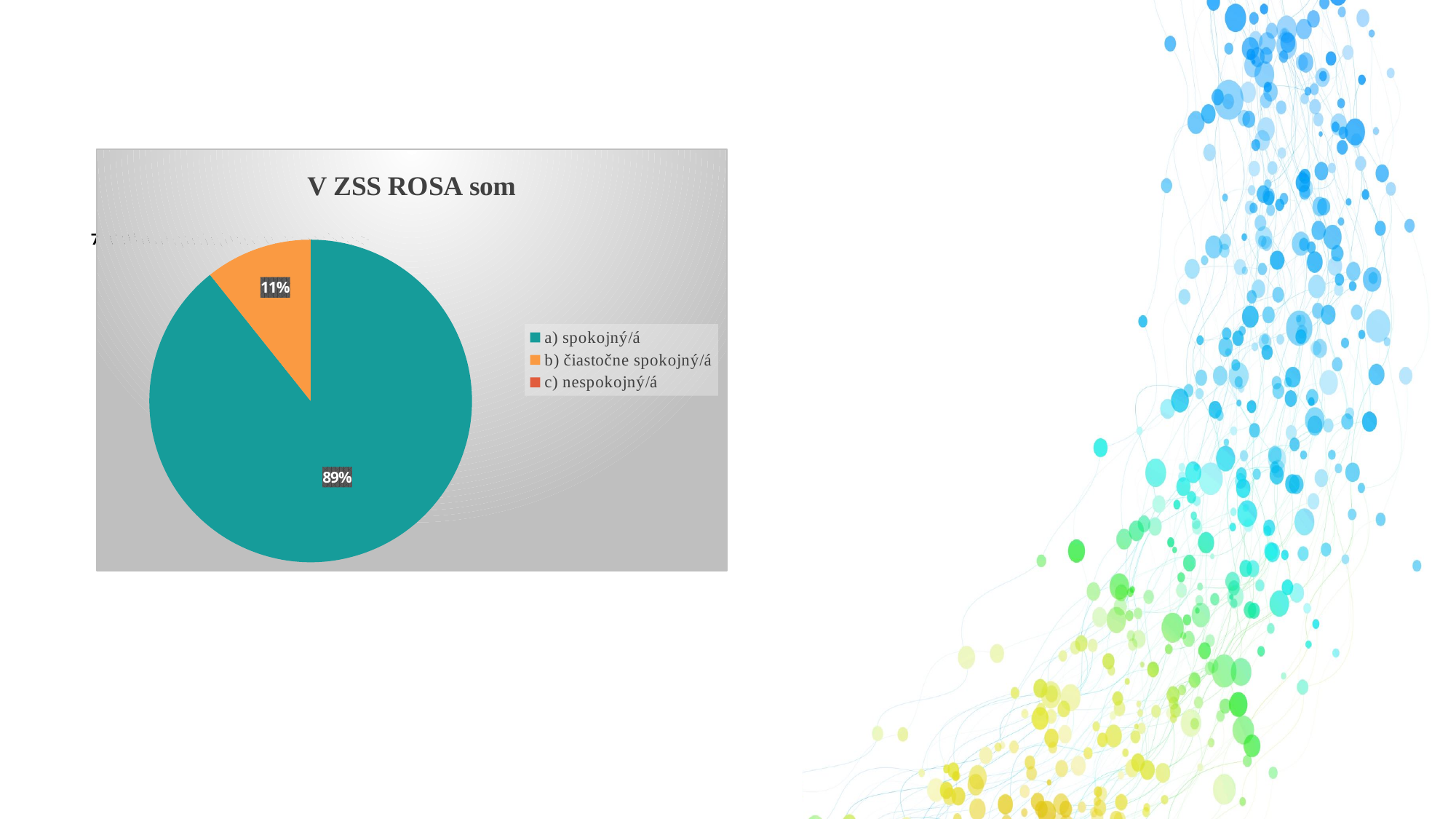
How many slices with a visible data label does the pie have? 2 Which category has the largest slice of the pie? a) spokojný/á Is the share for "a) spokojný/á" greater or less than 50%? greater How many entries does the legend list? 3 What share of the pie does "a) spokojný/á" take? 89% What colour is the slice for "b) čiastočne spokojný/á"? orange Which is larger, the slice for "a) spokojný/á" or the slice for "b) čiastočne spokojný/á"? a) spokojný/á What is the title of the chart? V ZSS ROSA som What share of the pie does "b) čiastočne spokojný/á" take? 11% What is the difference in percentage points between the "a) spokojný/á" slice and the "b) čiastočne spokojný/á" slice? 78 percentage points What kind of chart is shown on the slide? pie chart